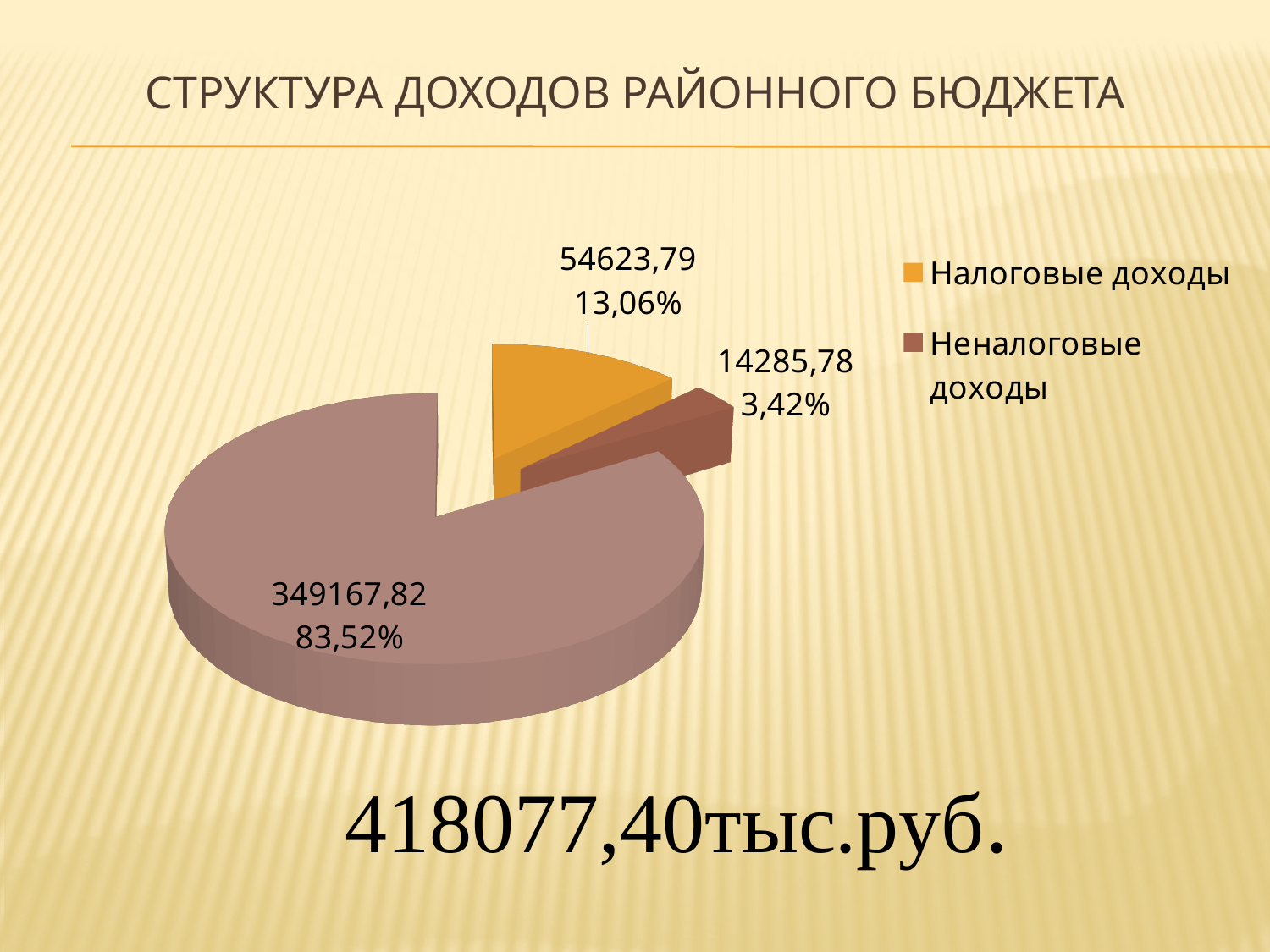
How many slices does the pie chart have? 3 Which of the legend categories is the smallest slice of the pie? Неналоговые доходы What is the difference in percentage share between Налоговые доходы and Неналоговые доходы? 9,64% What kind of chart is shown on the slide? Pie chart What is the value of the largest slice of the pie? 349167,82 What share of the pie does Неналоговые доходы represent? 3,42% What is the value shown for Налоговые доходы? 54623,79 How many entries does the legend list? 2 What is the difference between the values for Налоговые доходы and Неналоговые доходы? 40338,01 What is the value shown for Неналоговые доходы? 14285,78 What share of the pie does Налоговые доходы represent? 13,06% Which is larger, Налоговые доходы or Неналоговые доходы? Налоговые доходы